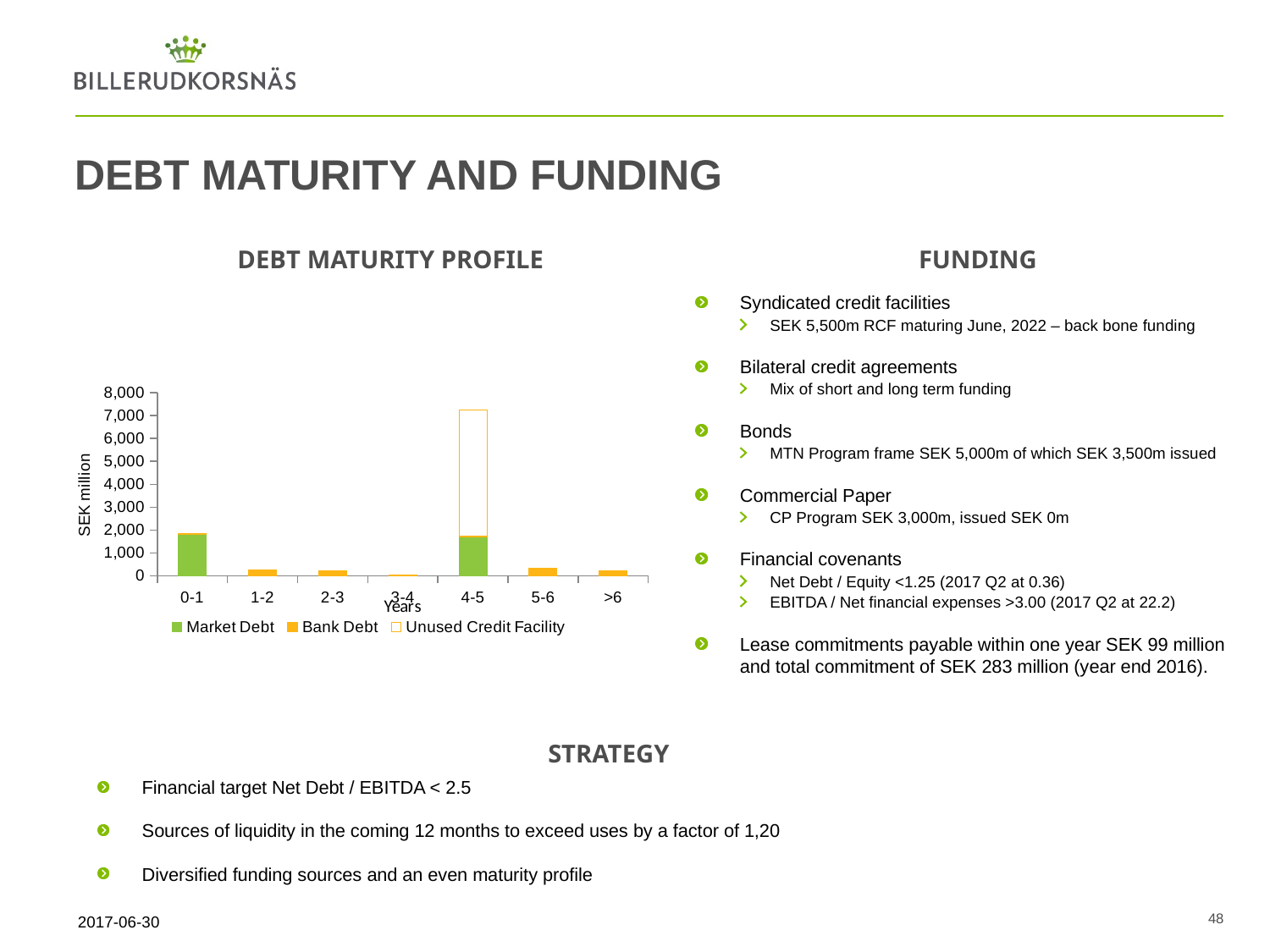
In the Debt Maturity Profile chart, is the total bar for 4-5 years greater or less than 6,000? greater In the Debt Maturity Profile chart, is the total bar for 0-1 years greater or less than 2,000? less In the Debt Maturity Profile chart, is the total bar for 0-1 years greater or less than 1,000? greater In the Debt Maturity Profile chart, which bar is taller: 0-1 years or 1-2 years? 0-1 Which maturity category has the smallest bar in the Debt Maturity Profile chart? 3-4 Which series in the Debt Maturity Profile chart is shown as an unfilled (white) bar? Unused Credit Facility How many maturity categories are shown on the x axis of the Debt Maturity Profile chart? 7 How many series does the legend of the Debt Maturity Profile chart list? 3 Which maturity category has the tallest bar in the Debt Maturity Profile chart? 4-5 What kind of chart is the Debt Maturity Profile chart? bar chart What is the label of the vertical axis in the Debt Maturity Profile chart? SEK million